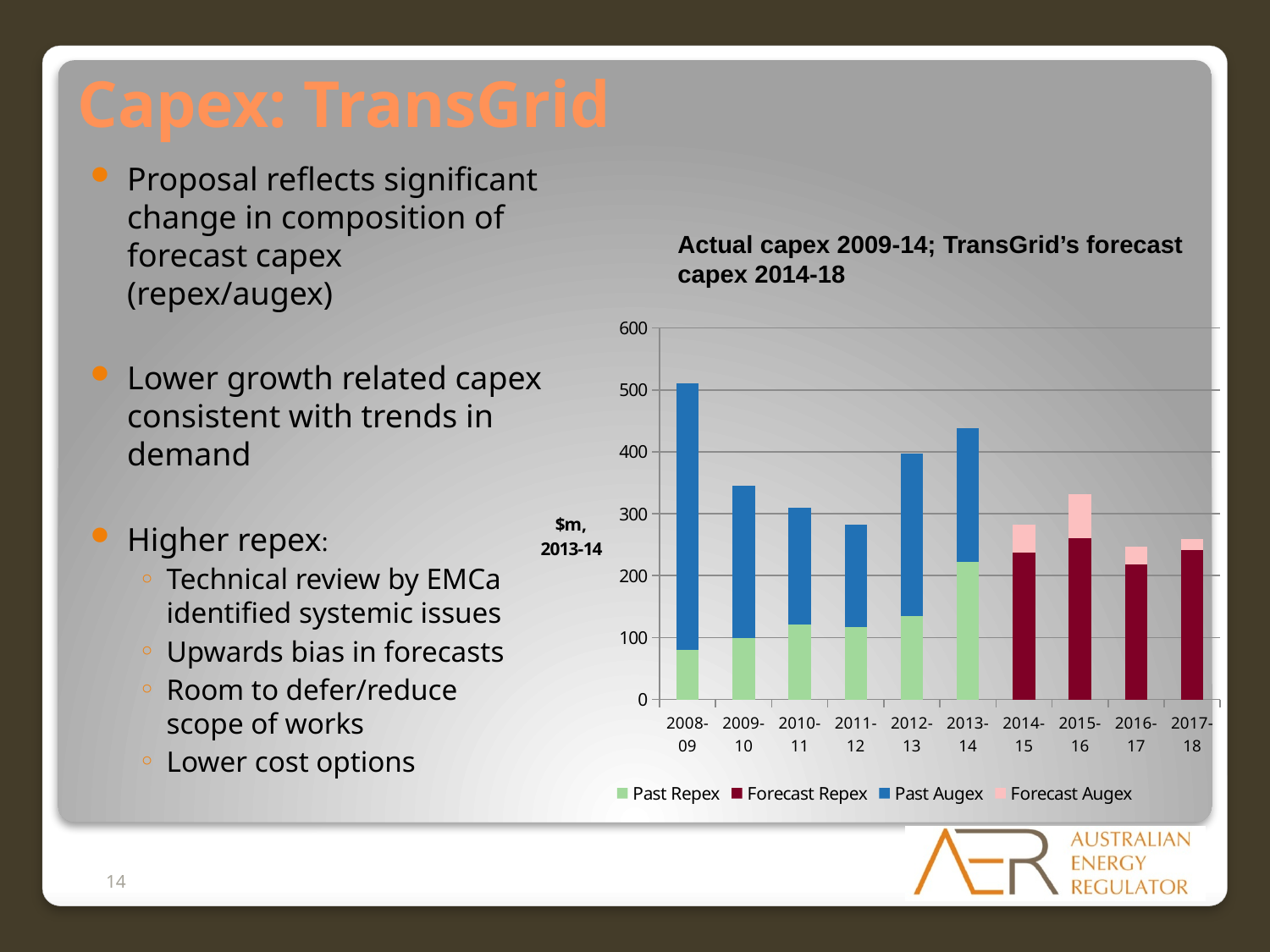
Is the Past Repex value for 2008-09 greater or less than 100? less Is the total capex for 2011-12 greater or less than 300? less Is the total capex for 2013-14 greater or less than 400? greater What unit label is shown on the vertical axis of the chart? $m, 2013-14 Which year has the larger total capex bar, 2012-13 or 2011-12? 2012-13 What is the title of the chart? Actual capex 2009-14; TransGrid's forecast capex 2014-18 Does the Past Repex series rise or fall from 2008-09 to 2013-14? rise Which year has the highest total capex bar in the chart? 2008-09 How many series does the chart legend list? 4 How many year categories are shown on the x axis of the chart? 10 What kind of chart is shown on the slide? Stacked bar chart